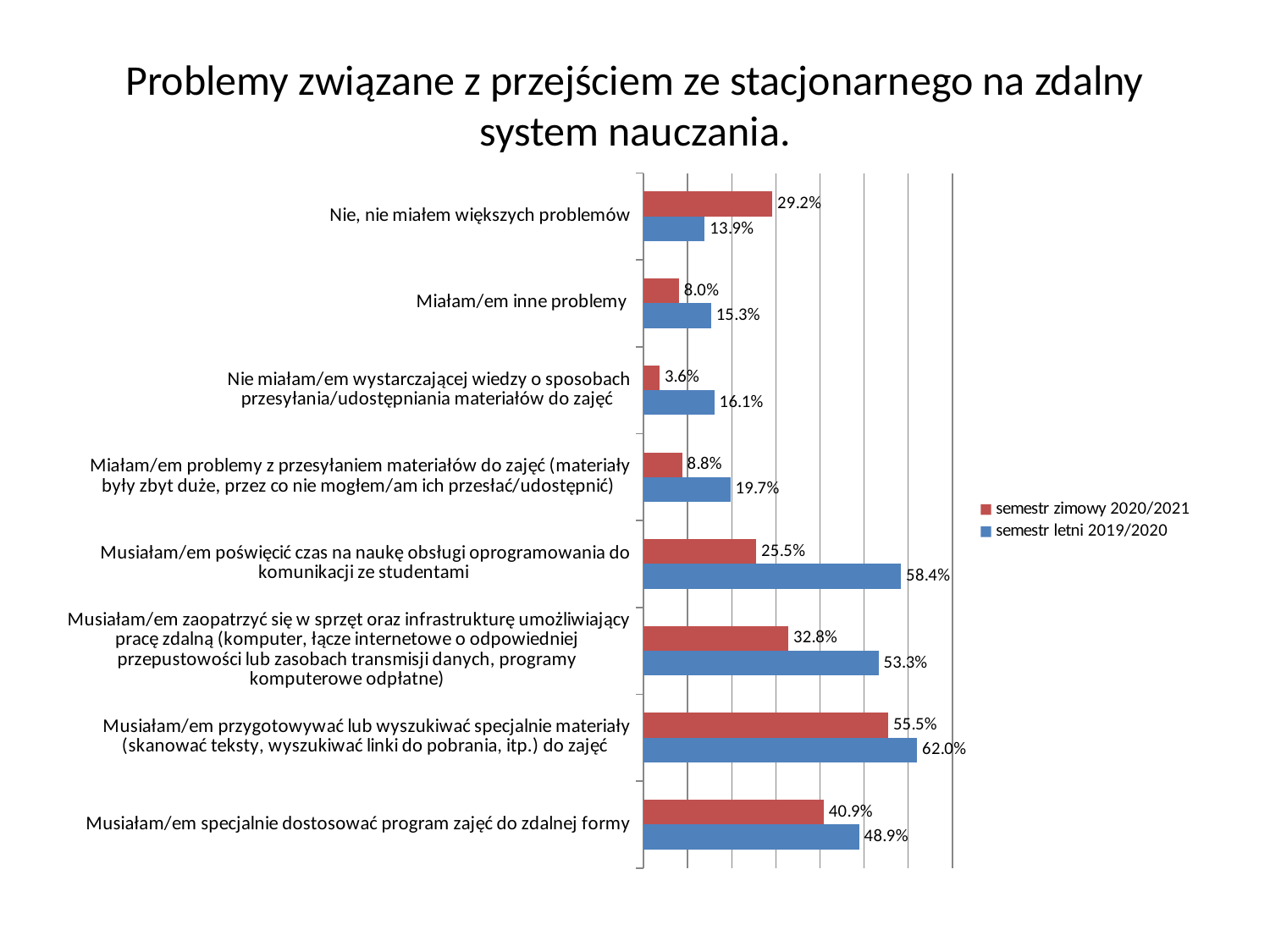
How many categories (problems) are shown on the chart? 8 For 'Nie, nie miałem większych problemów', which semester has the larger value? semestr zimowy 2020/2021 What is the value for 'Musiałam/em poświęcić czas na naukę obsługi oprogramowania do komunikacji ze studentami' in semestr letni 2019/2020? 58.4% What is the difference between the semestr letni 2019/2020 and semestr zimowy 2020/2021 values for 'Musiałam/em poświęcić czas na naukę obsługi oprogramowania do komunikacji ze studentami'? 32.9% How many series does the legend list? 2 What is the value for 'Nie, nie miałem większych problemów' in semestr zimowy 2020/2021? 29.2% Which colour represents semestr letni 2019/2020 in the chart? blue Which category has the highest value for semestr letni 2019/2020? Musiałam/em przygotowywać lub wyszukiwać specjalnie materiały (skanować teksty, wyszukiwać linki do pobrania, itp.) do zajęć For 'Miałam/em inne problemy', which semester has the larger value? semestr letni 2019/2020 What is the value for 'Musiałam/em specjalnie dostosować program zajęć do zdalnej formy' in semestr zimowy 2020/2021? 40.9% Which category has the lowest value for semestr zimowy 2020/2021? Nie miałam/em wystarczającej wiedzy o sposobach przesyłania/udostępniania materiałów do zajęć What type of chart is shown on the slide? bar chart